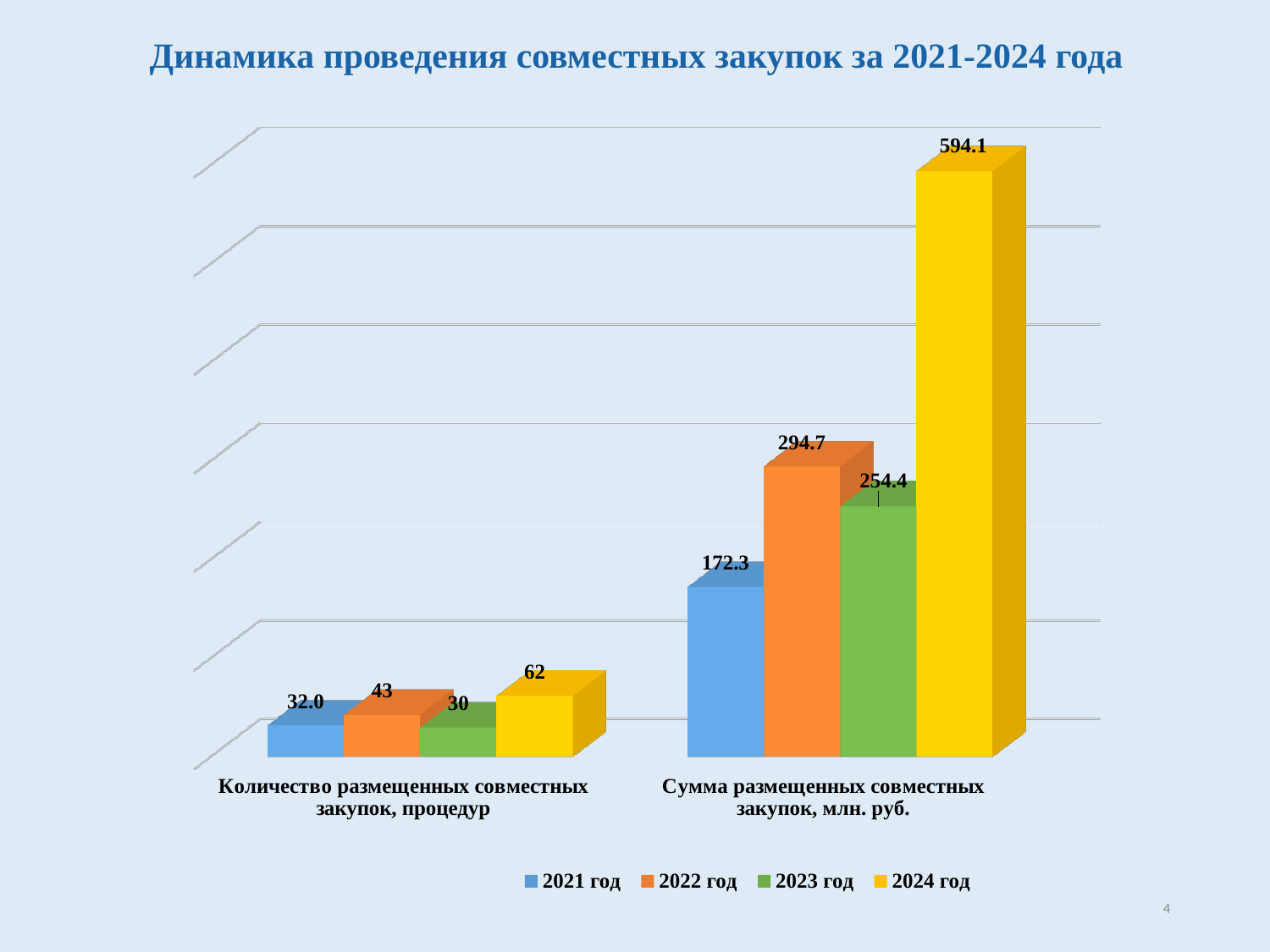
Which year has the lowest value in the category 'Сумма размещенных совместных закупок, млн. руб.'? 2021 год In the category 'Количество размещенных совместных закупок, процедур', which is larger: the value for 2022 год or 2023 год? 2022 год What is the value for 2021 год in the category 'Количество размещенных совместных закупок, процедур'? 32.0 How many categories are shown on the x axis? 2 Which year has the highest value in the category 'Количество размещенных совместных закупок, процедур'? 2024 год What is the value for 2023 год in the category 'Сумма размещенных совместных закупок, млн. руб.'? 254.4 What is the difference between the 2022 год and 2021 год values in the category 'Количество размещенных совместных закупок, процедур'? 11 What is the title of the chart? Динамика проведения совместных закупок за 2021-2024 года How many series does the legend list? 4 What type of chart is shown on the slide? bar chart What is the difference between the 2024 год and 2023 год values in the category 'Сумма размещенных совместных закупок, млн. руб.'? 339.7 What is the value for 2024 год in the category 'Сумма размещенных совместных закупок, млн. руб.'? 594.1